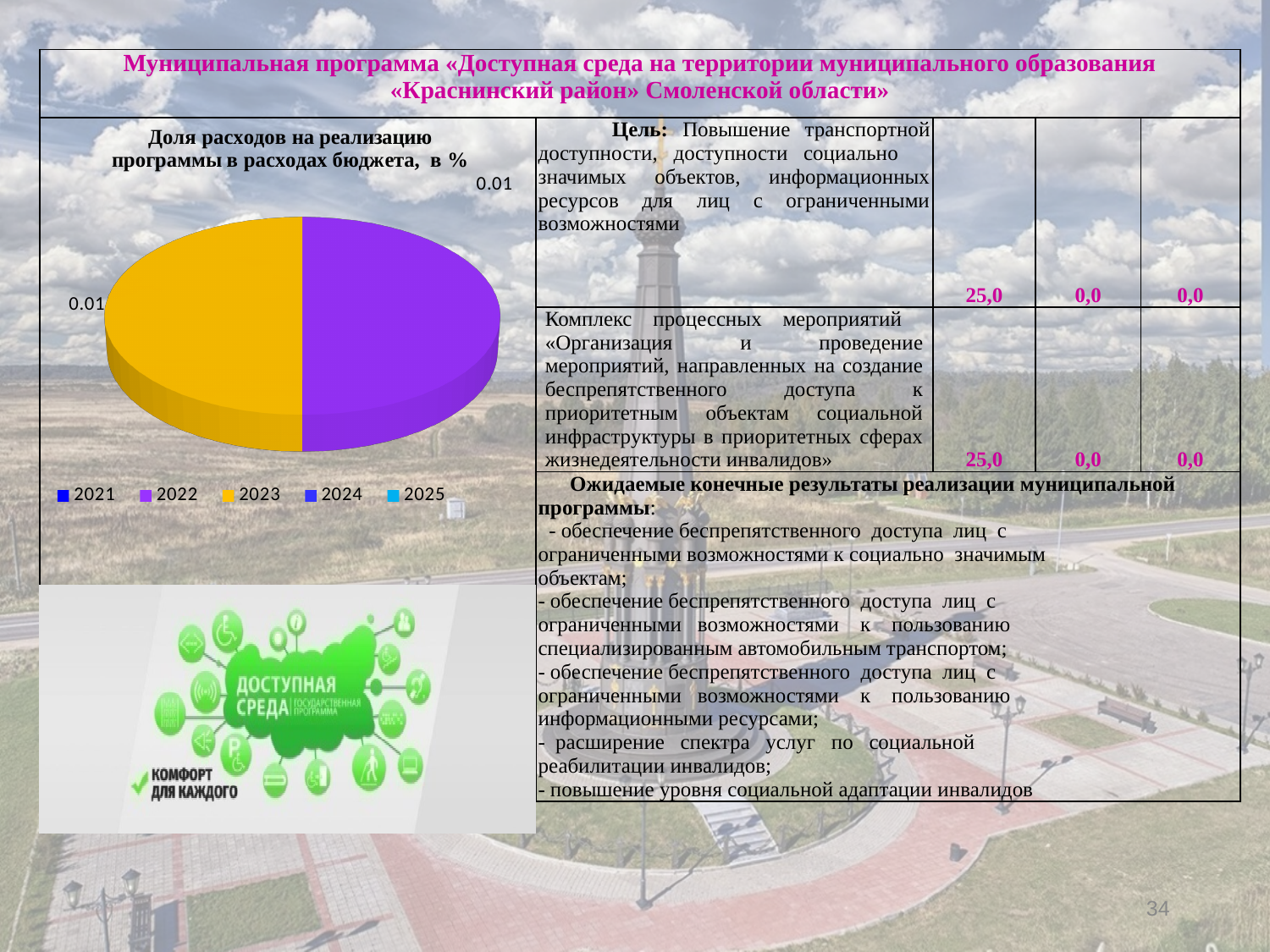
What kind of chart is shown on the slide? pie chart What value is labelled on the 2022 slice of the pie chart? 0.01 Which colour represents 2023 in the pie chart? yellow What share of the pie does the 2022 slice represent, based on the labelled values? 50% How many entries does the legend of the pie chart list? 5 What is the title of the pie chart? Доля расходов на реализацию программы в расходах бюджета, в % How many slices are visible in the pie chart? 2 What value is labelled on the 2023 slice of the pie chart? 0.01 What is the difference between the labelled values for 2022 and 2023 in the pie chart? 0